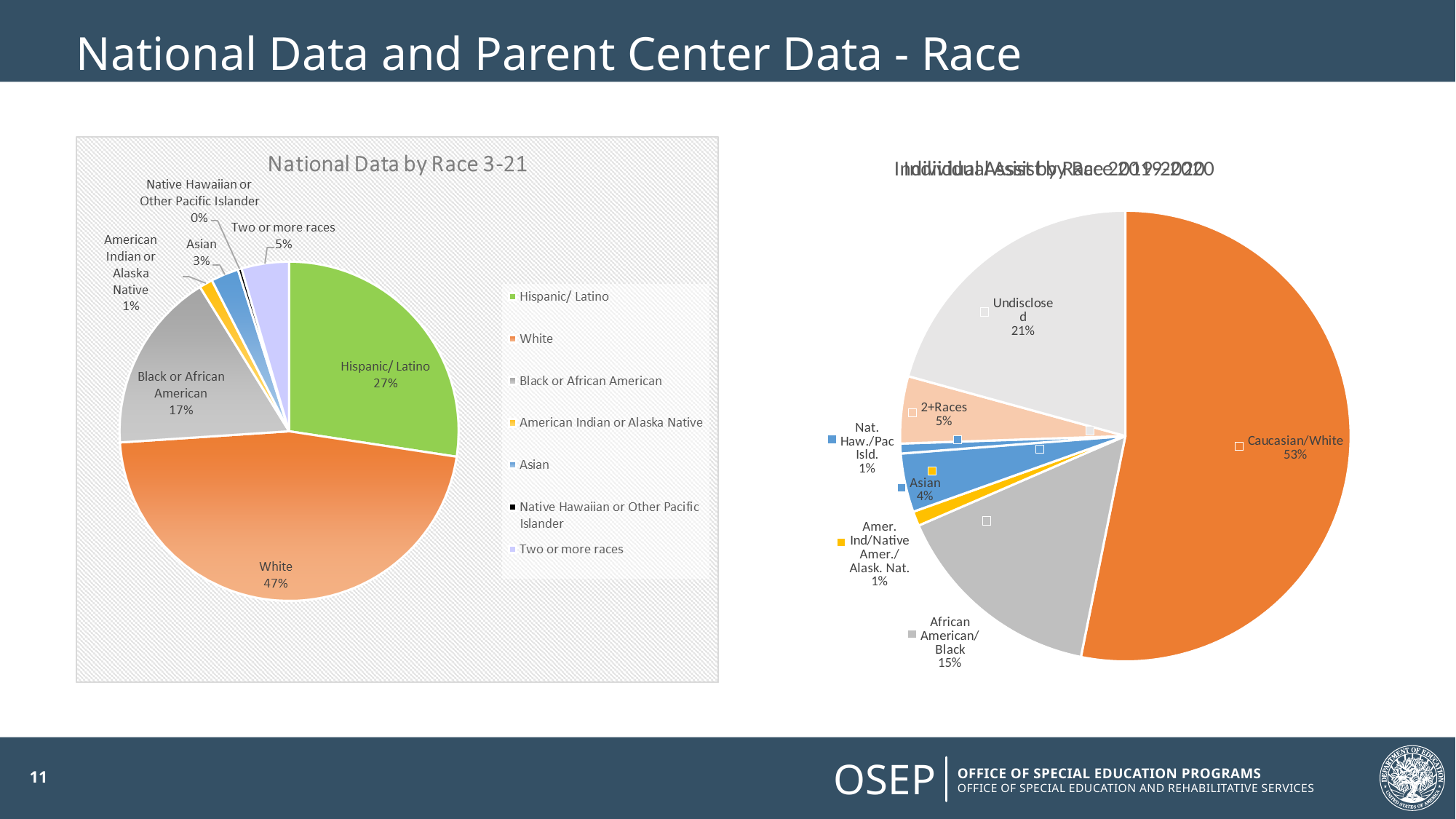
In the right pie chart, which is larger, African American/Black or Asian? African American/Black In the left chart, National Data by Race 3-21, which category has the smallest share? Native Hawaiian or Other Pacific Islander In the right pie chart, how many slices are there? 7 In the left chart, National Data by Race 3-21, which category has the largest share? White In the right pie chart, what share is Undisclosed? 21% In the left chart, National Data by Race 3-21, what share is Hispanic/ Latino? 27% In the right pie chart, what is the difference between the Undisclosed share and the African American/Black share? 6% In the left chart, National Data by Race 3-21, what share is White? 47% What kind of chart is the left chart, National Data by Race 3-21? Pie chart In the right pie chart, what share is Caucasian/White? 53% In the left chart, National Data by Race 3-21, how many entries does the legend list? 7 In the left chart, National Data by Race 3-21, what is the difference between the White share and the Hispanic/ Latino share? 20%